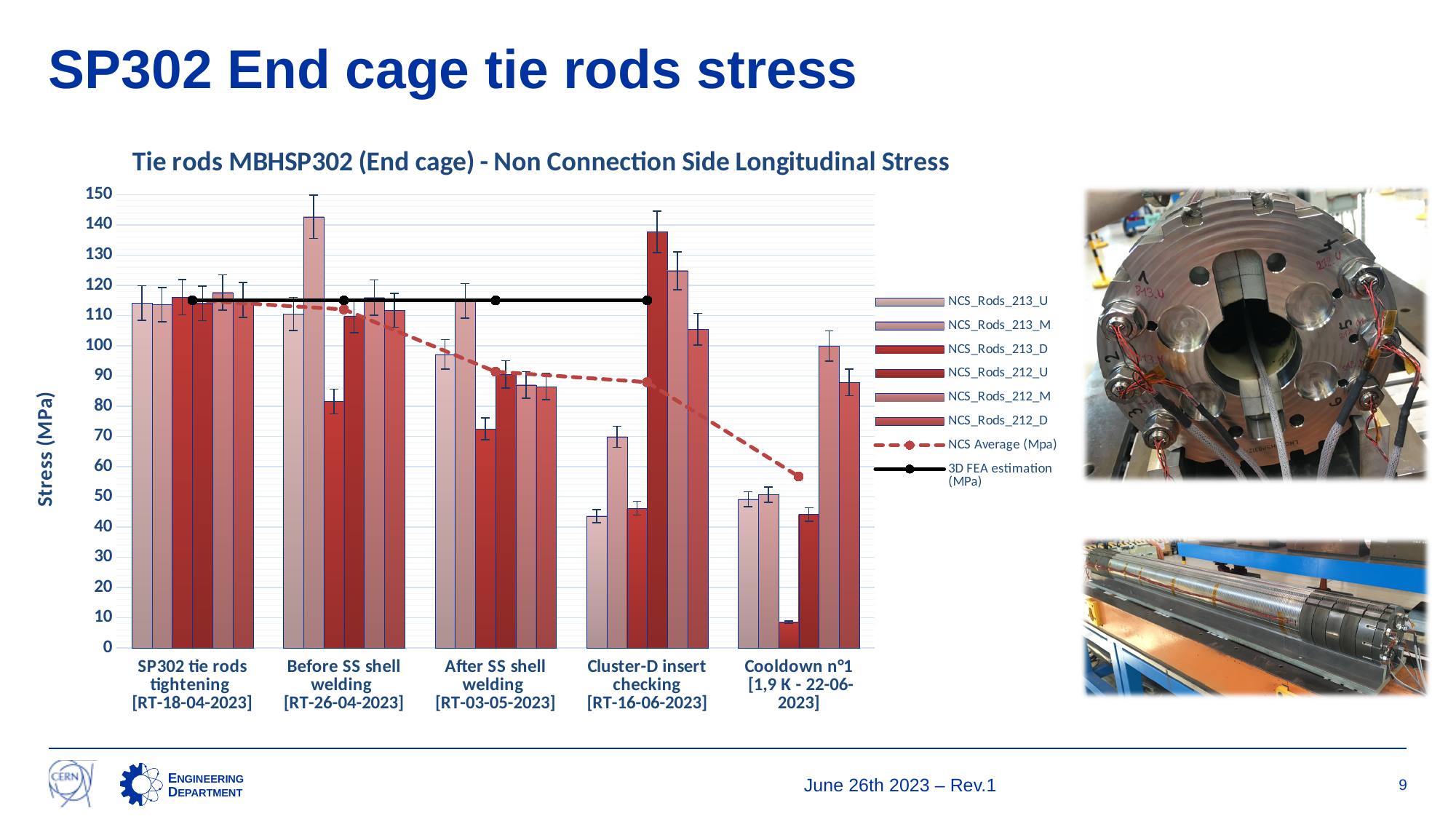
What kind of chart is shown on the slide? combination bar and line chart Is the value for NCS_Rods_213_D at 'Before SS shell welding [RT-26-04-2023]' greater or less than 90? less Is the value for NCS_Rods_213_M at 'Before SS shell welding [RT-26-04-2023]' greater or less than 130? greater What is the title of the chart? Tie rods MBHSP302 (End cage) - Non Connection Side Longitudinal Stress Is the value for NCS_Rods_213_D at 'Cooldown n°1 [1,9 K - 22-06-2023]' greater or less than 20? less Does the NCS Average (Mpa) line rise or fall from the first category to the last? fall How many series does the chart legend list? 8 At 'Cluster-D insert checking [RT-16-06-2023]', which series has the highest bar? NCS_Rods_212_U How many categories are shown along the x axis of the chart? 5 What is the label of the vertical axis? Stress (MPa) At 'Cooldown n°1 [1,9 K - 22-06-2023]', which is larger: NCS_Rods_212_M or NCS_Rods_213_D? NCS_Rods_212_M